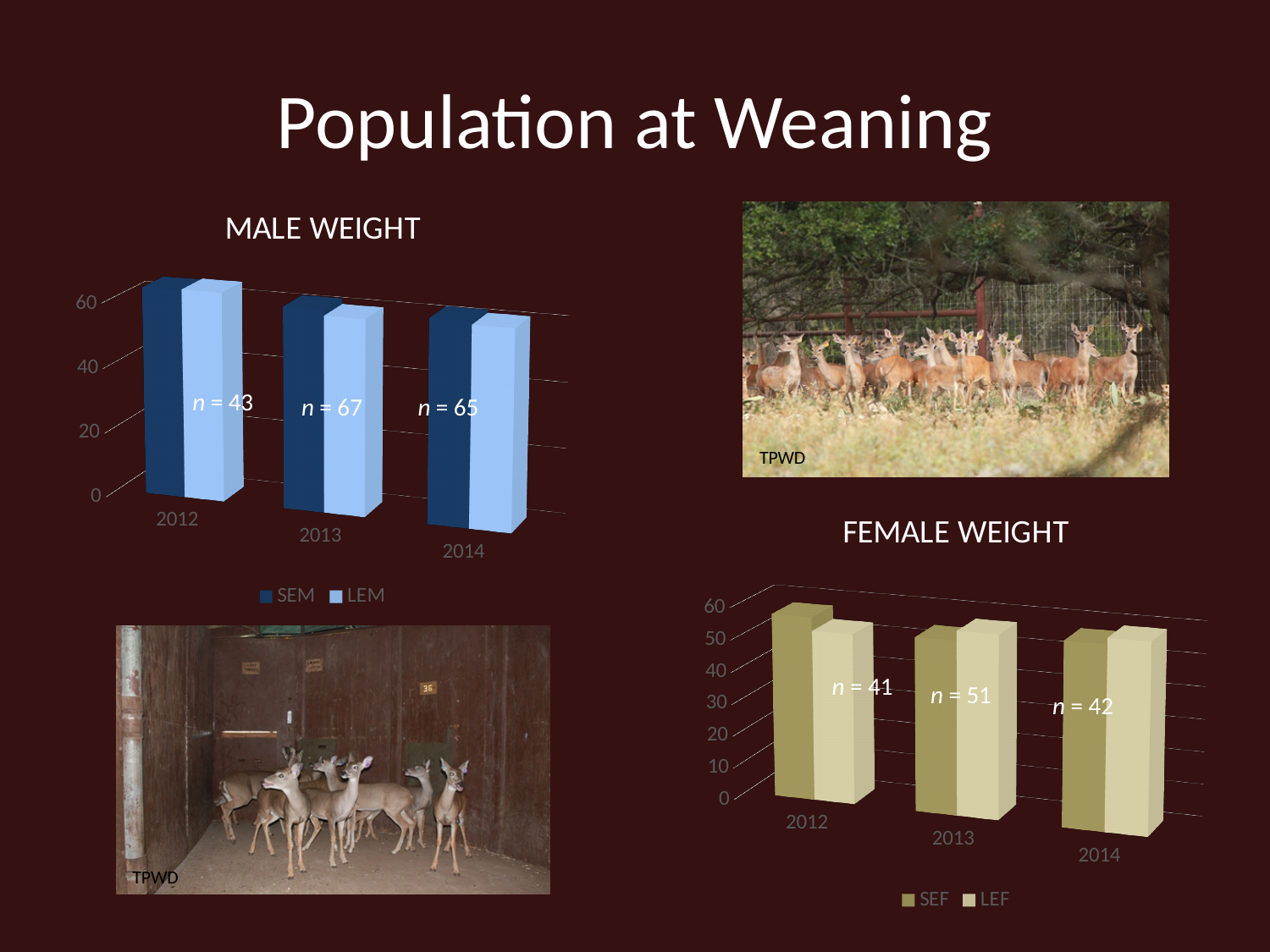
In the FEMALE WEIGHT chart, what sample size (n) is printed for 2014? n = 42 In the FEMALE WEIGHT chart, is the LEF value for 2014 greater or less than 30? greater What are the two legend entries of the FEMALE WEIGHT chart? SEF and LEF In the MALE WEIGHT chart, what sample size (n) is printed for 2013? n = 67 What kind of chart is the MALE WEIGHT chart? bar chart How many years are shown on the x axis of the FEMALE WEIGHT chart? 3 How many series does the legend of the MALE WEIGHT chart list? 2 In the MALE WEIGHT chart, which year has the tallest SEM bar? 2012 In the MALE WEIGHT chart, do the SEM bars rise or fall from 2012 to 2014? fall In the MALE WEIGHT chart, is the SEM value for 2012 greater or less than 40? greater